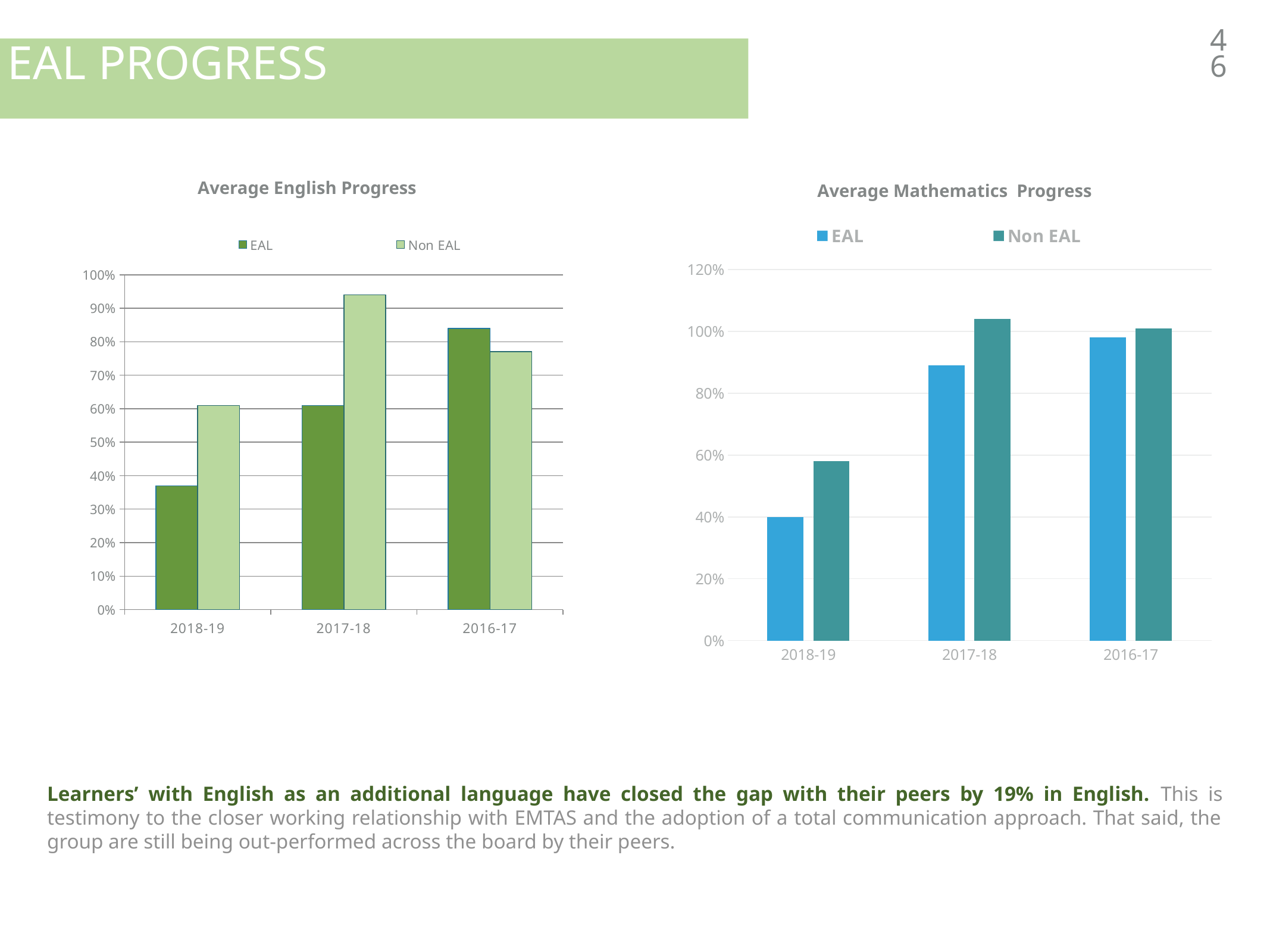
In the Average English Progress chart, which year has the lowest EAL value? 2018-19 In the Average English Progress chart, is the Non EAL value for 2017-18 greater or less than 90%? greater How many series does the legend of the Average Mathematics Progress chart list? 2 In the Average Mathematics Progress chart, which year has the lowest EAL value? 2018-19 What is the title of the chart on the right side of the slide? Average Mathematics Progress In the Average English Progress chart, is the EAL value for 2018-19 greater or less than 40%? less In the Average English Progress chart, which series has the larger value for 2016-17, EAL or Non EAL? EAL How many year categories are shown on the x axis of the Average English Progress chart? 3 In the Average Mathematics Progress chart, is the Non EAL value for 2017-18 greater or less than 100%? greater In the Average English Progress chart, which year has the highest Non EAL value? 2017-18 What type of chart is the Average English Progress chart? bar chart